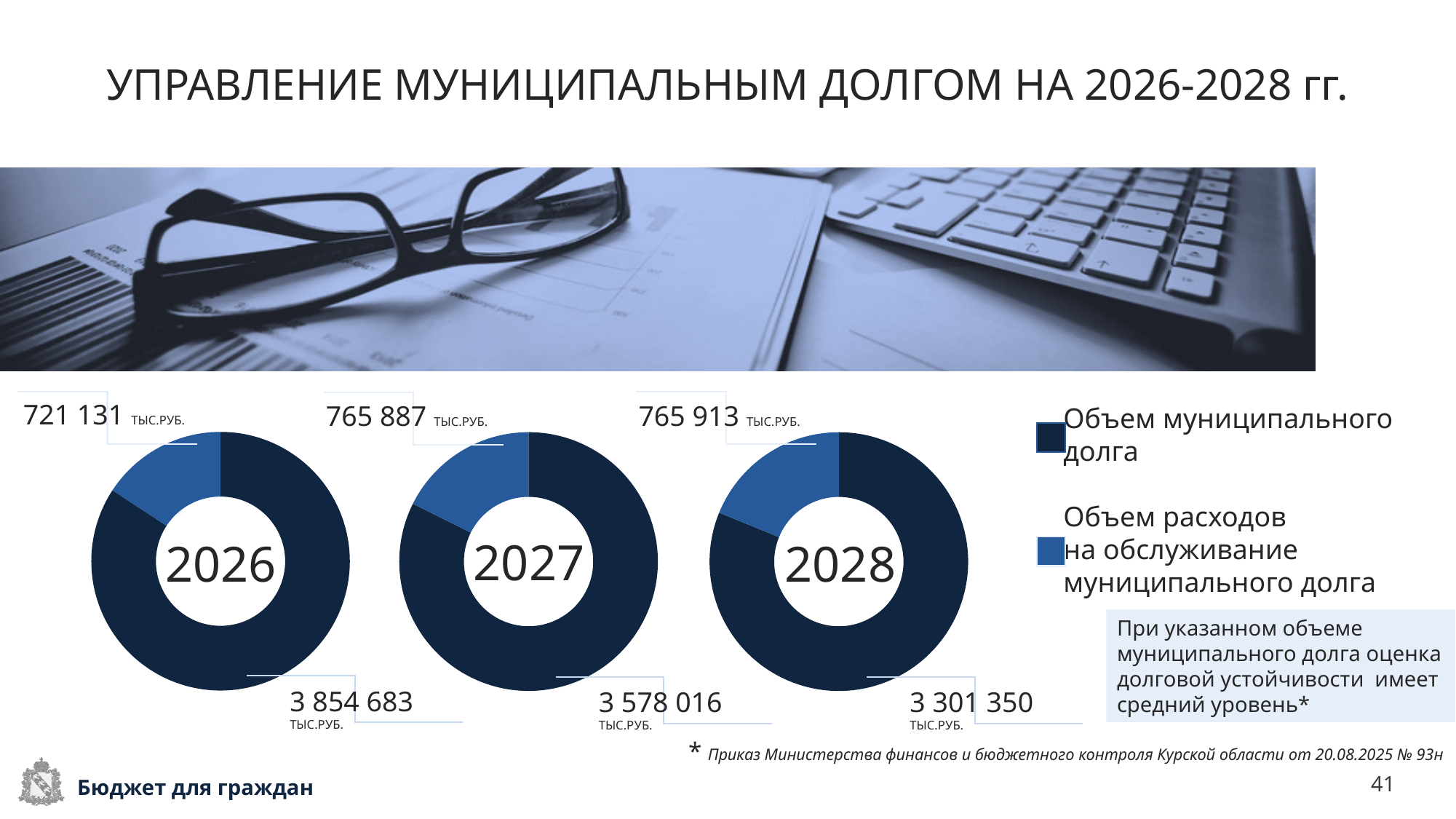
Which year's chart shows the highest value for Объем муниципального долга? 2026 How many series does the legend list? 2 In the 2028 chart, which is larger: Объем муниципального долга or Объем расходов на обслуживание муниципального долга? Объем муниципального долга In the 2026 chart, what is the value for Объем муниципального долга? 3 854 683 тыс.руб. In the 2027 chart, what is the value for Объем расходов на обслуживание муниципального долга? 765 887 тыс.руб. What is the difference between Объем муниципального долга in the 2026 chart and in the 2027 chart? 276 667 тыс.руб. Across the 2026, 2027 and 2028 charts, does the value for Объем муниципального долга rise or fall? Falls In the 2028 chart, what is the value for Объем муниципального долга? 3 301 350 тыс.руб. How many donut charts are on the slide? 3 In the 2026 chart, what is the value for Объем расходов на обслуживание муниципального долга? 721 131 тыс.руб. What kind of charts are shown on the slide? Donut (pie) charts What is the total of the two values in the 2026 chart? 4 575 814 тыс.руб.